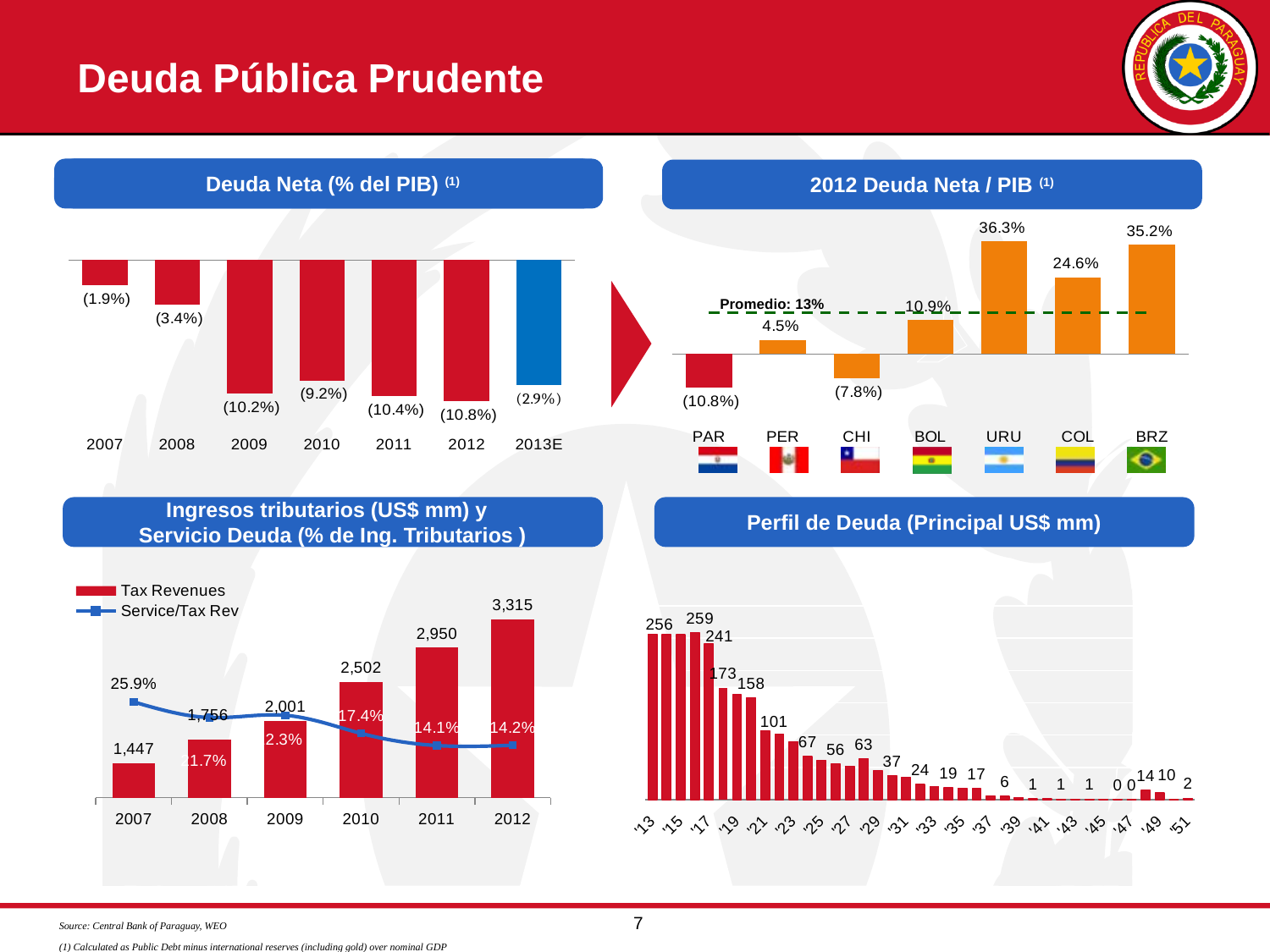
In the '2012 Deuda Neta / PIB' chart, what is the value for PAR? (10.8%) In the '2012 Deuda Neta / PIB' chart, what average (Promedio) is marked by the dashed line? 13% In the 'Ingresos tributarios' chart, what is the Tax Revenues value for 2012? 3,315 In the 'Perfil de Deuda (Principal US$ mm)' chart, what is the highest value shown? 259 In the 'Ingresos tributarios' chart, what is the difference in Tax Revenues between 2012 and 2011? 365 How many series does the legend of the 'Ingresos tributarios' chart list? 2 In the '2012 Deuda Neta / PIB' chart, which country has the highest value? URU In the '2012 Deuda Neta / PIB' chart, what is the value for COL? 24.6% In the 'Deuda Neta (% del PIB)' chart, what is the value for 2007? (1.9%) In the 'Deuda Neta (% del PIB)' chart, what is the value for 2012? (10.8%) How many years are shown on the x axis of the 'Deuda Neta (% del PIB)' chart? 7 In the 'Ingresos tributarios' chart, what is the Service/Tax Rev value for 2007? 25.9%